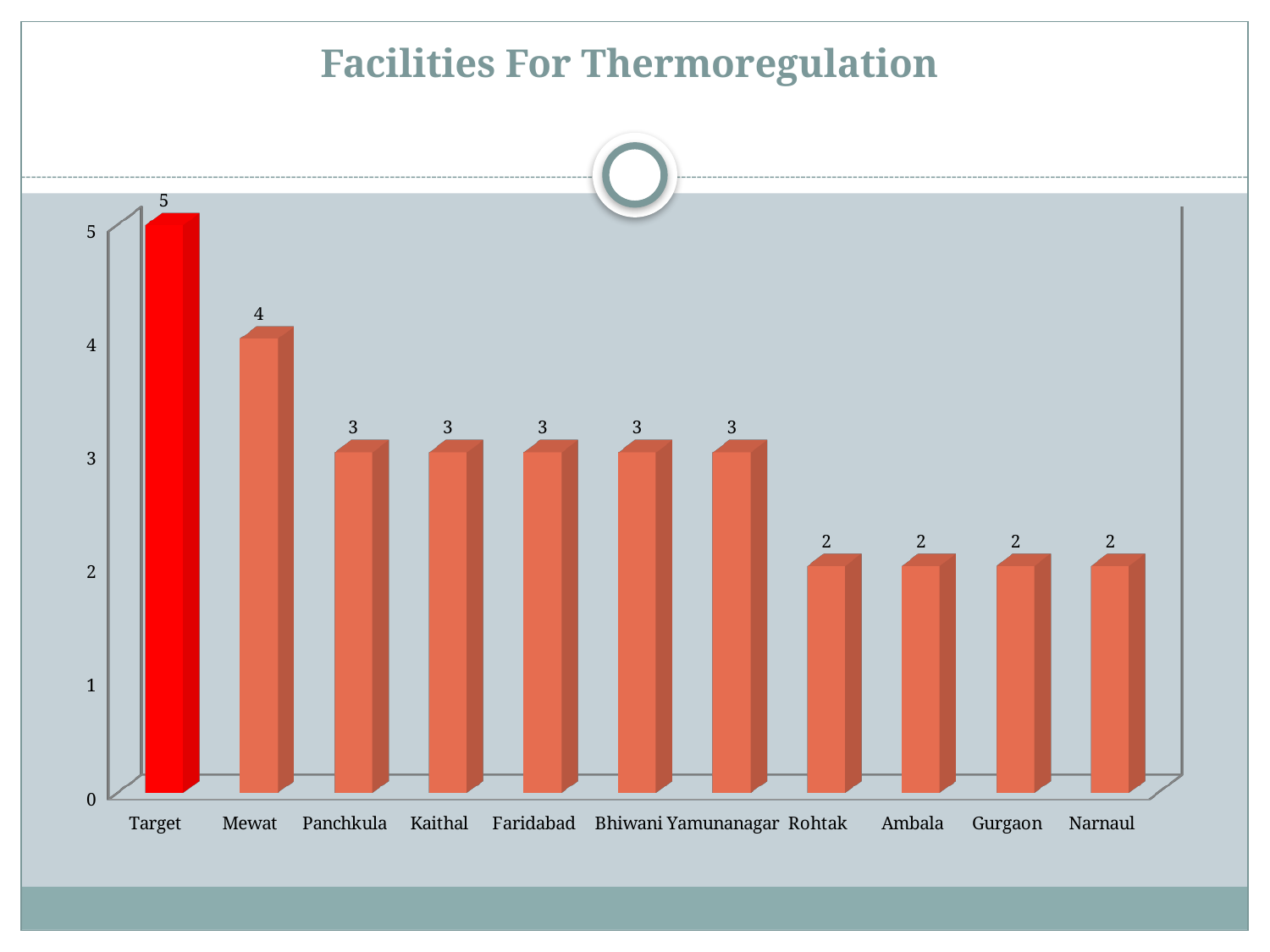
Do the values rise or fall from left to right along the x axis? Fall What is the difference between the values for Mewat and Narnaul? 2 Which is larger, the value for Panchkula or the value for Gurgaon? Panchkula What is the difference between the values for Target and Mewat? 1 What is the title of the chart? Facilities For Thermoregulation What is the value for Target? 5 Which category has the highest value? Target How many categories are shown on the x axis? 11 What is the value for Yamunanagar? 3 What kind of chart is shown on the slide? Bar chart What is the value for Rohtak? 2 What is the value for Mewat? 4